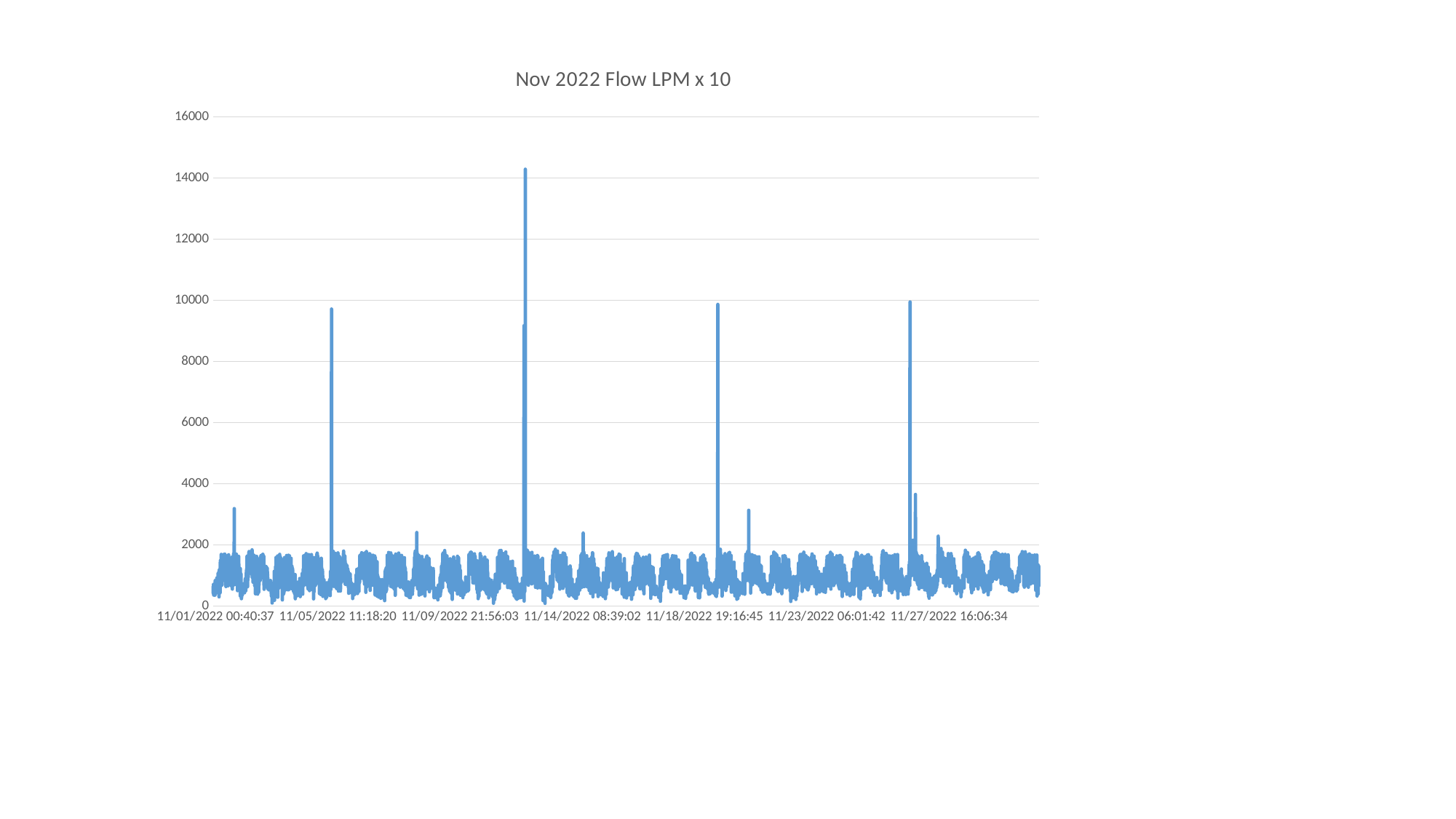
Is the spike near 11/27/2022 16:06:34 greater or less than 6000? greater Which spike is taller: the one near 11/05/2022 11:18:20 or the one between 11/09/2022 21:56:03 and 11/14/2022 08:39:02? the one between 11/09/2022 21:56:03 and 11/14/2022 08:39:02 Is the spike near 11/05/2022 11:18:20 greater or less than 8000? greater Is the tallest spike in the chart greater or less than 16000? less What is the first date label on the horizontal axis? 11/01/2022 00:40:37 What kind of chart is shown on the slide? line chart How many spikes in the chart rise above 8000? 4 How many date labels are printed along the horizontal axis? 7 What is the title of the chart? Nov 2022 Flow LPM x 10 What is the highest value shown on the vertical axis of the chart? 16000